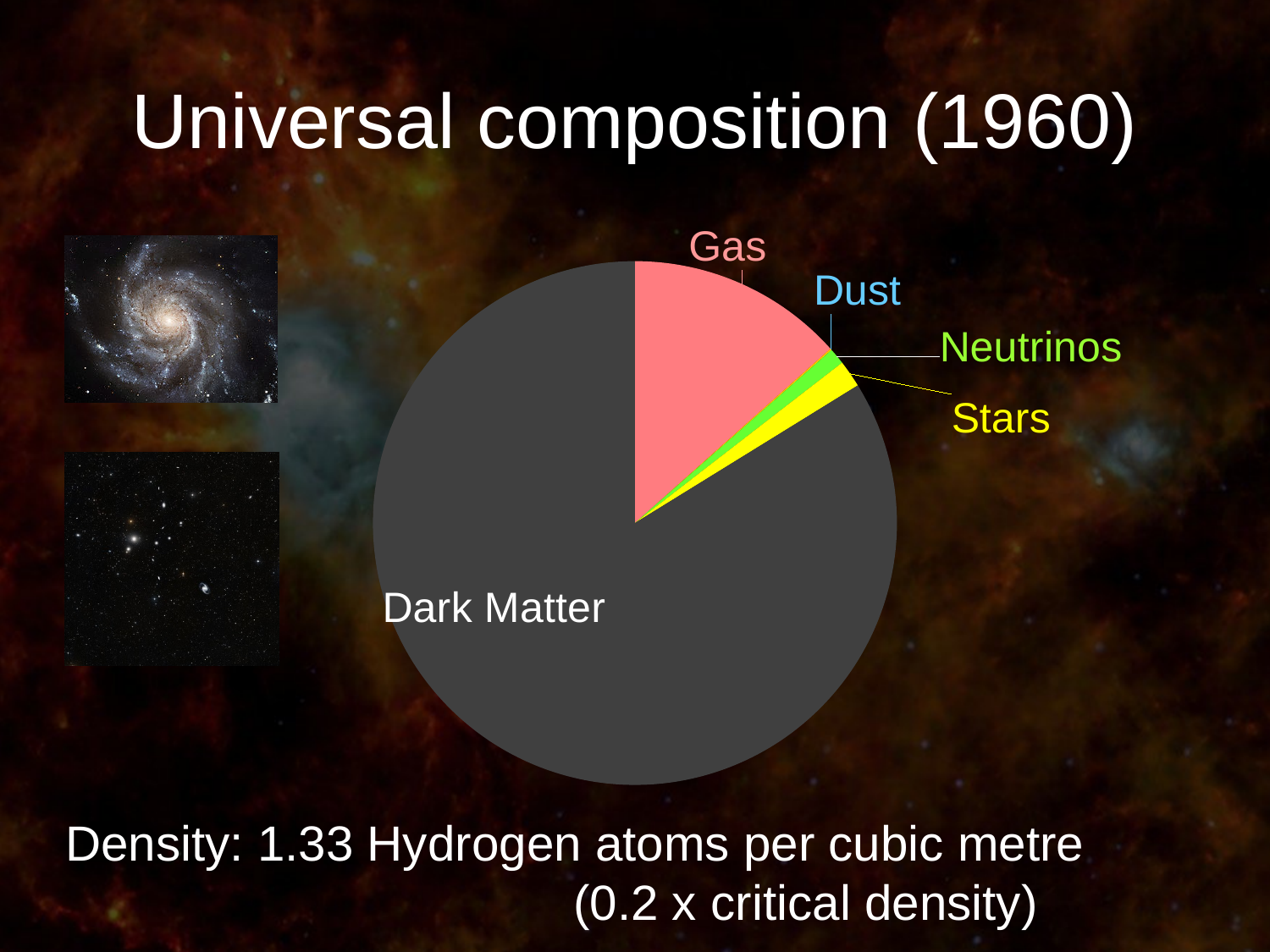
What is the title of the chart on the slide? Universal composition (1960) How many slices does the pie chart have? 5 Which category has the largest slice of the pie chart? Dark Matter Which category is the second-largest slice of the pie chart? Gas What kind of chart is shown on the slide? Pie chart What colour is the Gas slice in the pie chart? Pink Which slice is larger, Gas or Stars? Gas Is the Dark Matter slice greater or less than half of the pie? greater Which slice is larger, Stars or Dust? Stars Which slice is larger, Dark Matter or Gas? Dark Matter